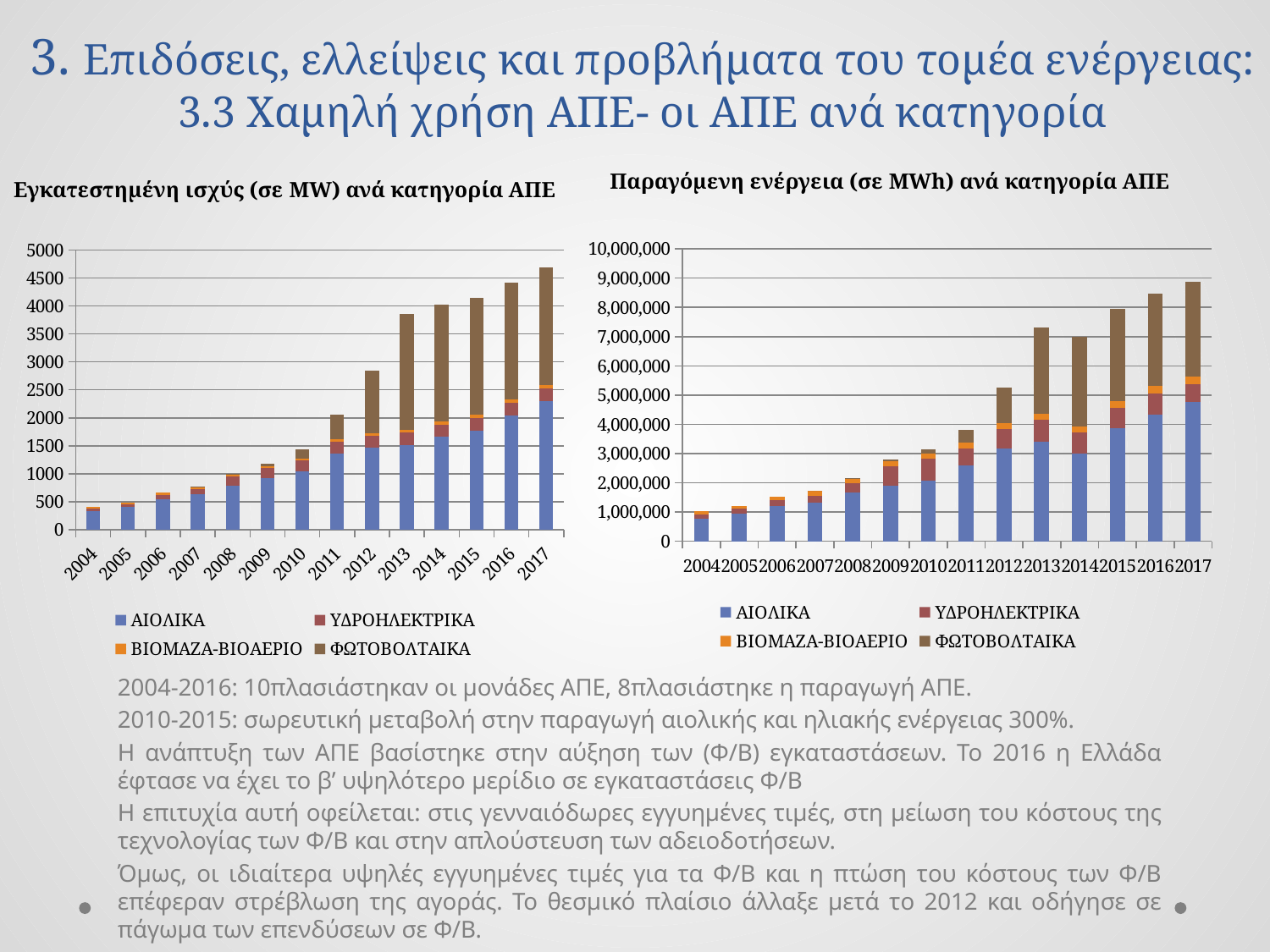
In the left chart, 'Εγκατεστημένη ισχύς (σε MW) ανά κατηγορία ΑΠΕ', which year has the highest total installed capacity? 2017 In the left chart, 'Εγκατεστημένη ισχύς (σε MW) ανά κατηγορία ΑΠΕ', is the total value for 2017 greater or less than 4500? greater In the right chart, 'Παραγόμενη ενέργεια (σε MWh) ανά κατηγορία ΑΠΕ', is the total value for 2016 greater or less than 8,000,000? greater What kind of chart is the left chart, 'Εγκατεστημένη ισχύς (σε MW) ανά κατηγορία ΑΠΕ'? Stacked bar chart In the left chart, which colour represents the ΦΩΤΟΒΟΛΤΑΙΚΑ series? Brown In the right chart, 'Παραγόμενη ενέργεια (σε MWh) ανά κατηγορία ΑΠΕ', which year has the larger total: 2012 or 2013? 2013 In the left chart, 'Εγκατεστημένη ισχύς (σε MW) ανά κατηγορία ΑΠΕ', do the total values generally rise or fall from 2004 to 2017? Rise In the left chart, 'Εγκατεστημένη ισχύς (σε MW) ανά κατηγορία ΑΠΕ', is the total value for 2012 greater or less than 2500? greater How many series does the legend of the right chart, 'Παραγόμενη ενέργεια (σε MWh) ανά κατηγορία ΑΠΕ', list? 4 How many years are shown on the x axis of the left chart, 'Εγκατεστημένη ισχύς (σε MW) ανά κατηγορία ΑΠΕ'? 14 In the right chart, 'Παραγόμενη ενέργεια (σε MWh) ανά κατηγορία ΑΠΕ', which year has the lowest total produced energy? 2004